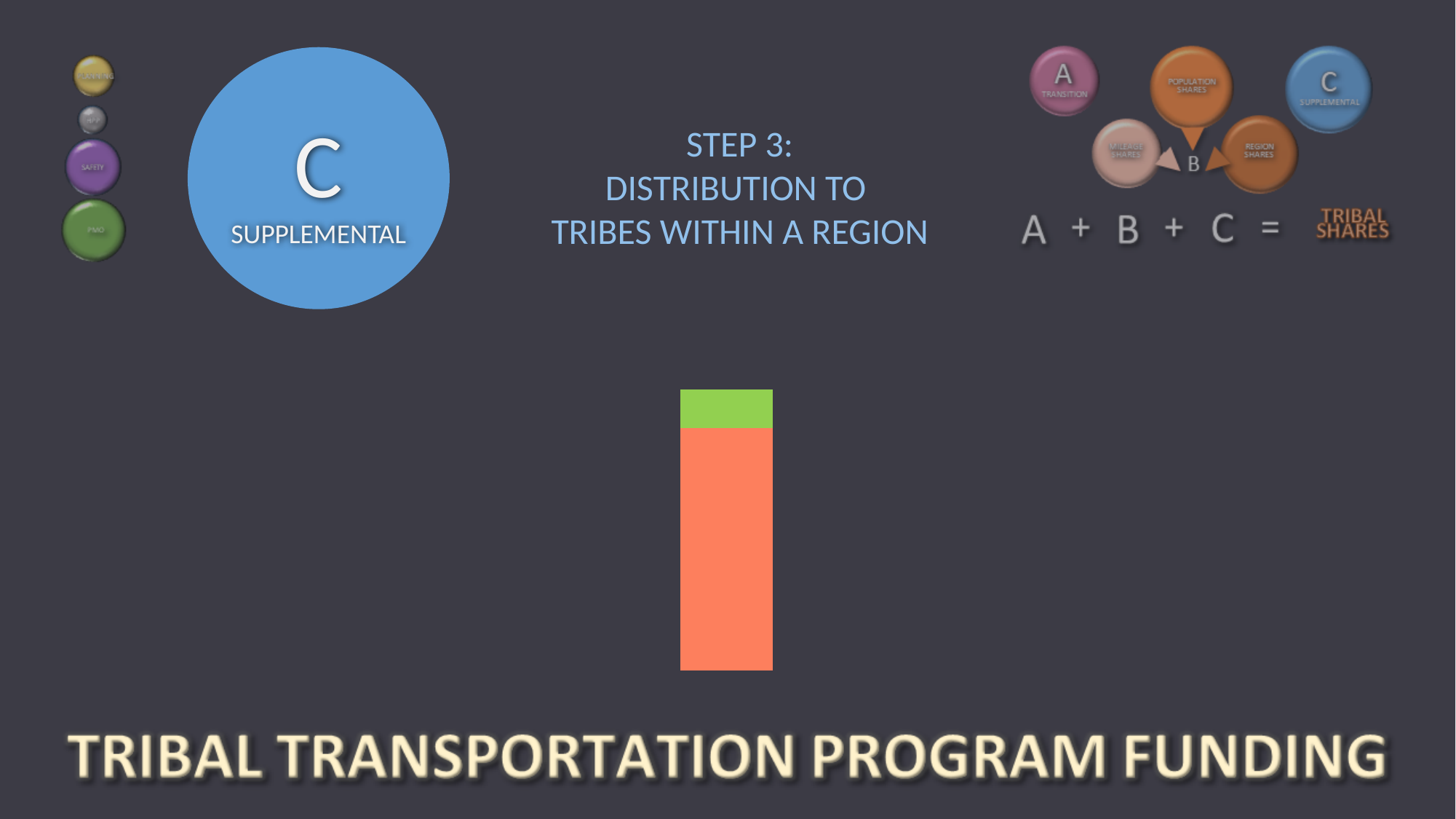
How many bars are plotted in the chart in the centre of the slide? 1 What kind of chart is shown in the centre of the slide? bar chart Which segment of the stacked bar in the centre of the slide is the smallest? the green segment What colour is the top segment of the stacked bar in the centre of the slide? green How many segments make up the stacked bar in the centre of the slide? 2 In the stacked bar in the centre of the slide, which segment is larger, the orange one or the green one? orange What colour is the bottom segment of the stacked bar in the centre of the slide? orange